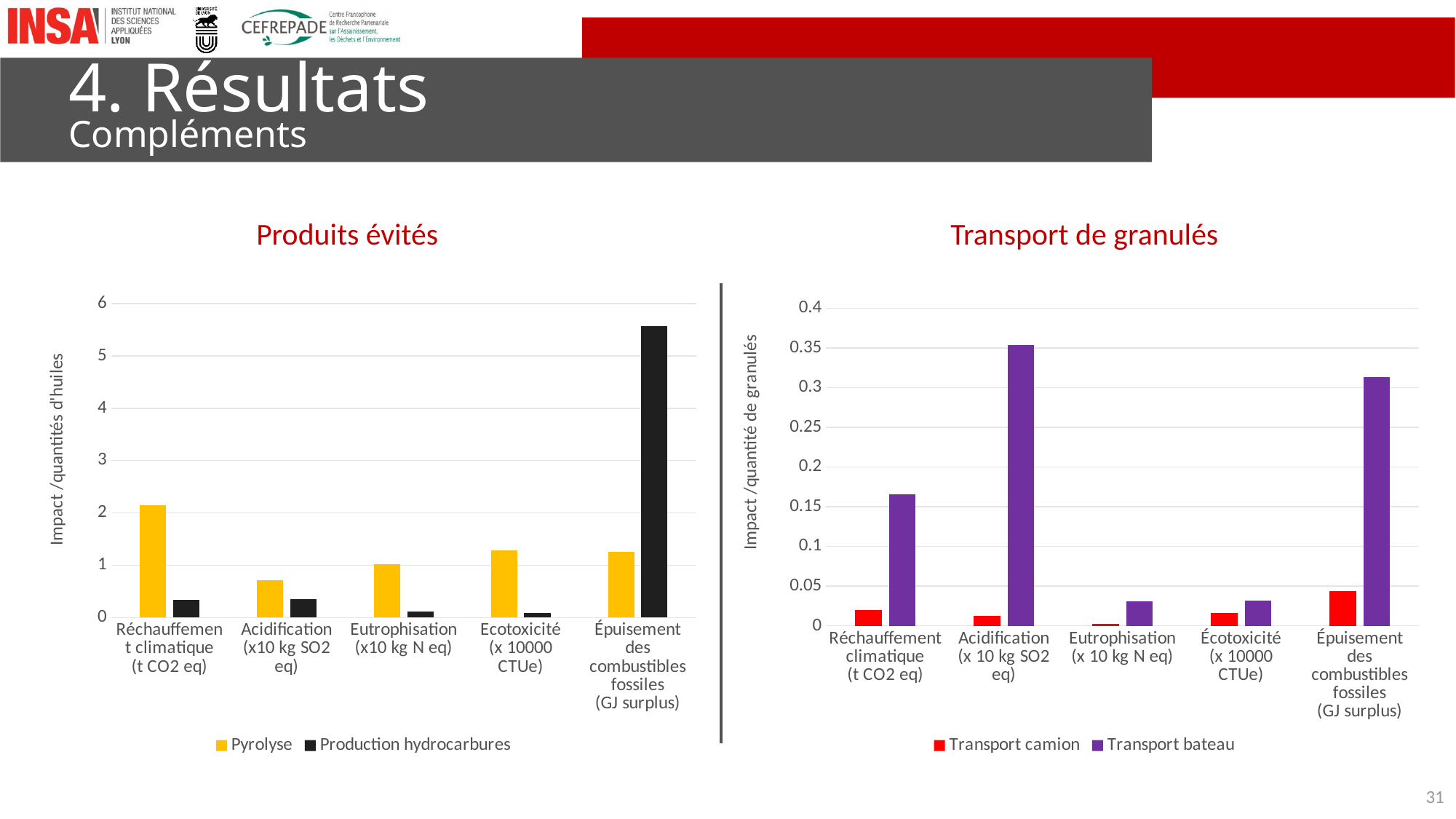
In the 'Produits évités' chart, for Ecotoxicité, which series has the larger value, Pyrolyse or Production hydrocarbures? Pyrolyse In the 'Transport de granulés' chart, which category has the highest value for Transport bateau? Acidification (x 10 kg SO2 eq) In the 'Transport de granulés' chart, which category has the lowest value for Transport camion? Eutrophisation (x 10 kg N eq) In the 'Produits évités' chart, which category has the highest value for Production hydrocarbures? Épuisement des combustibles fossiles (GJ surplus) In the 'Transport de granulés' chart, for Réchauffement climatique, which series has the larger value, Transport camion or Transport bateau? Transport bateau In the 'Produits évités' chart, is the Production hydrocarbures value for Épuisement des combustibles fossiles greater or less than 5? greater What is the y-axis title of the 'Transport de granulés' chart? Impact /quantité de granulés How many series does the legend of the 'Produits évités' chart list? 2 In the 'Transport de granulés' chart, is the Transport bateau value for Acidification greater or less than 0.3? greater In the 'Produits évités' chart, which category has the highest value for Pyrolyse? Réchauffement climatique (t CO2 eq) What kind of chart is the 'Produits évités' chart? bar chart How many impact categories are shown on the x axis of the 'Produits évités' chart? 5